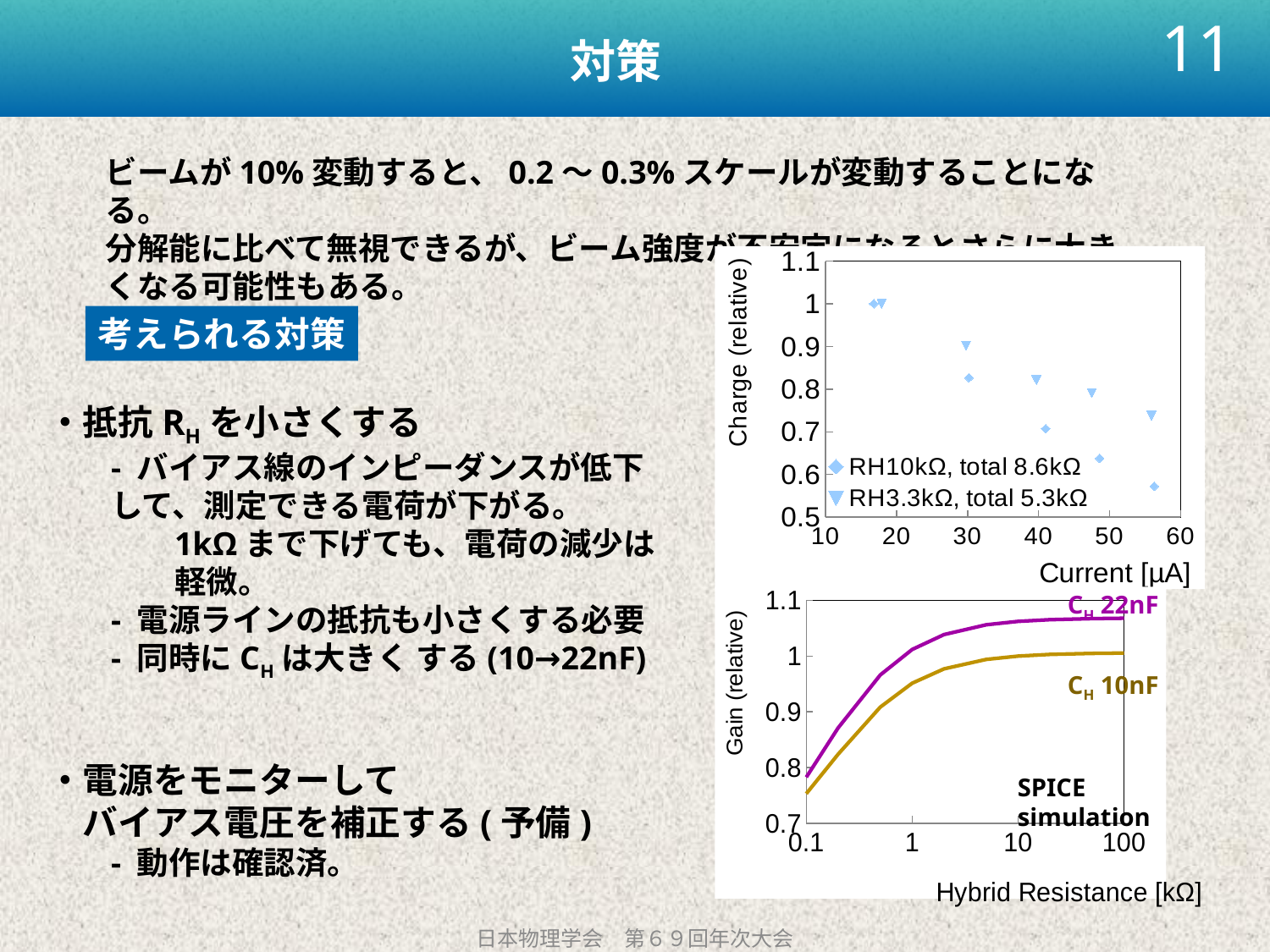
In the top chart, is the RH3.3kΩ, total 5.3kΩ value at about 56 µA greater or less than 0.7? greater In the bottom chart, what is the label of the x axis? Hybrid Resistance [kΩ] In the top chart, is the RH10kΩ, total 8.6kΩ value at 30 µA greater or less than 0.9? less In the bottom chart, which curve has the higher gain at 100 kΩ: CH 22nF or CH 10nF? CH 22nF What kind of chart is the bottom chart (Gain vs Hybrid Resistance)? line chart What kind of chart is the top chart (Charge vs Current)? scatter chart In the top chart, what is the label of the y axis? Charge (relative) In the top chart, does the charge rise or fall as the current increases? fall In the top chart, how many series does the legend list? 2 In the top chart, how many data points are plotted for the RH10kΩ, total 8.6kΩ series? 5 In the top chart, at 40 µA, which series has the higher charge: RH10kΩ, total 8.6kΩ or RH3.3kΩ, total 5.3kΩ? RH3.3kΩ, total 5.3kΩ In the bottom chart, does the gain rise or fall as the hybrid resistance increases? rise